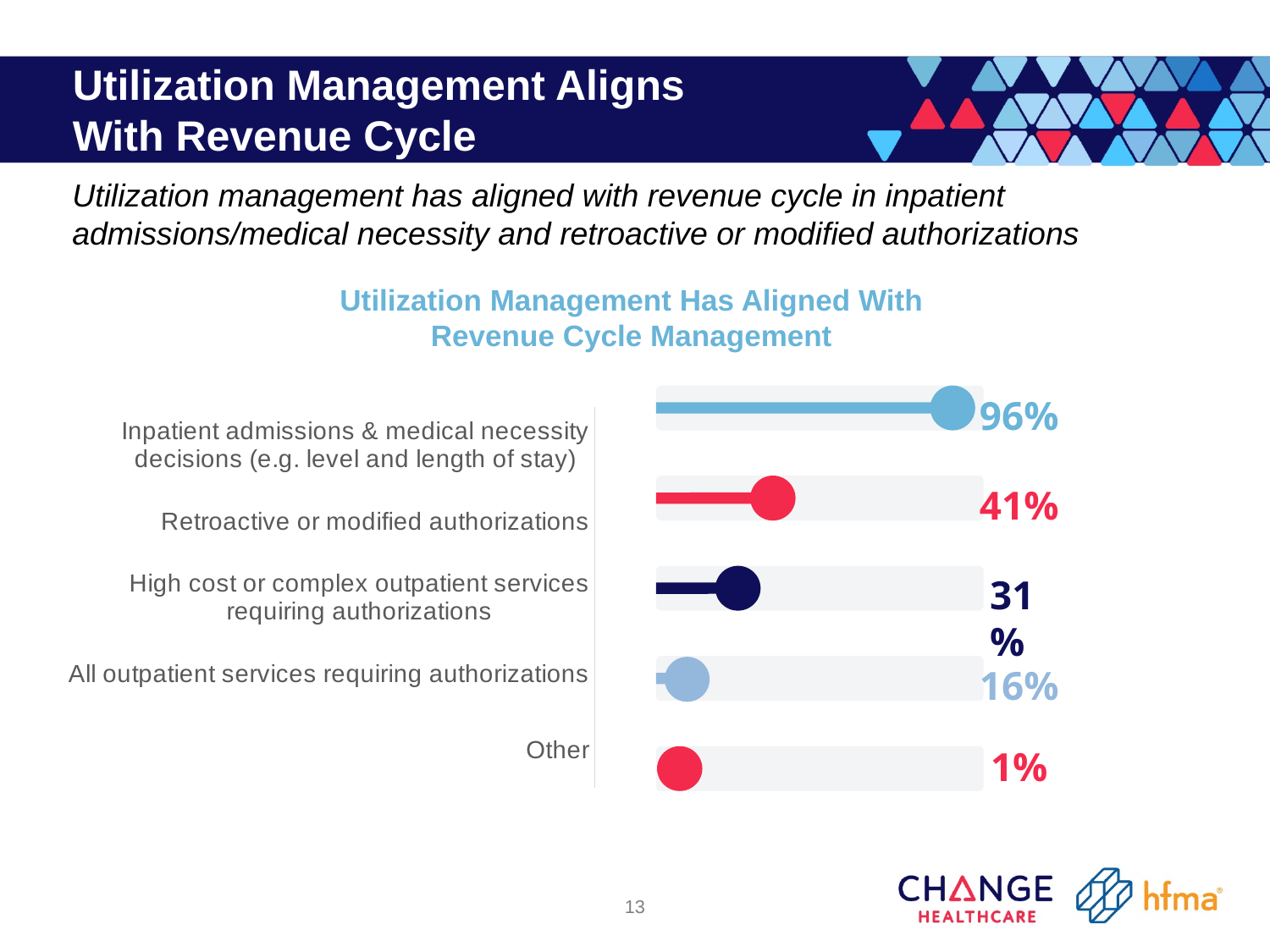
How many categories are shown in the chart? 5 What is the difference between the values for Inpatient admissions & medical necessity decisions and Retroactive or modified authorizations? 55% Which category has the highest value? Inpatient admissions & medical necessity decisions What is the value for Other? 1% What kind of chart is shown on the slide? Bar chart Which category has the lowest value? Other What is the title of the chart? Utilization Management Has Aligned With Revenue Cycle Management Which is larger: the value for Retroactive or modified authorizations or the value for All outpatient services requiring authorizations? Retroactive or modified authorizations What is the value for Inpatient admissions & medical necessity decisions? 96% What is the value for High cost or complex outpatient services requiring authorizations? 31% What is the value for All outpatient services requiring authorizations? 16% What is the value for Retroactive or modified authorizations? 41%